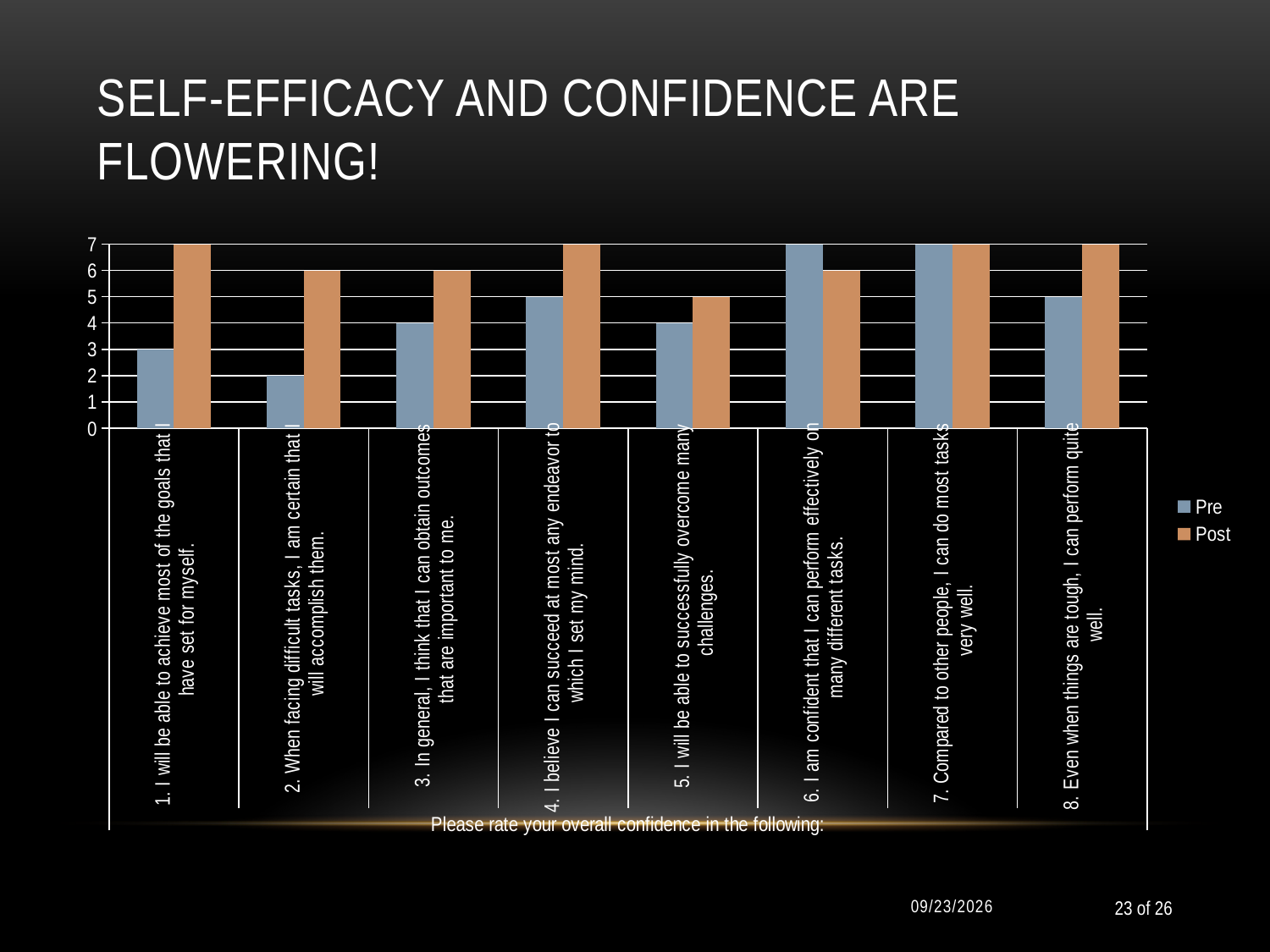
Which statement has the lowest Pre value? 2. When facing difficult tasks, I am certain that I will accomplish them. What is the Pre value for statement 6, 'I am confident that I can perform effectively on many different tasks'? 7 What is the Post value for statement 5, 'I will be able to successfully overcome many challenges'? 5 What type of chart is shown on the slide? bar chart For statement 6, which is larger, the Pre value or the Post value? Pre Is the Pre value for statement 4 greater or less than 4? greater How many series does the chart legend list? 2 How many statements (categories) are plotted on the x axis? 8 What is the Post value for statement 2, 'When facing difficult tasks, I am certain that I will accomplish them'? 6 What is the difference between the Post and Pre values for statement 1? 4 What is the Pre value for statement 1, 'I will be able to achieve most of the goals that I have set for myself'? 3 What are the two legend entries in the chart? Pre and Post